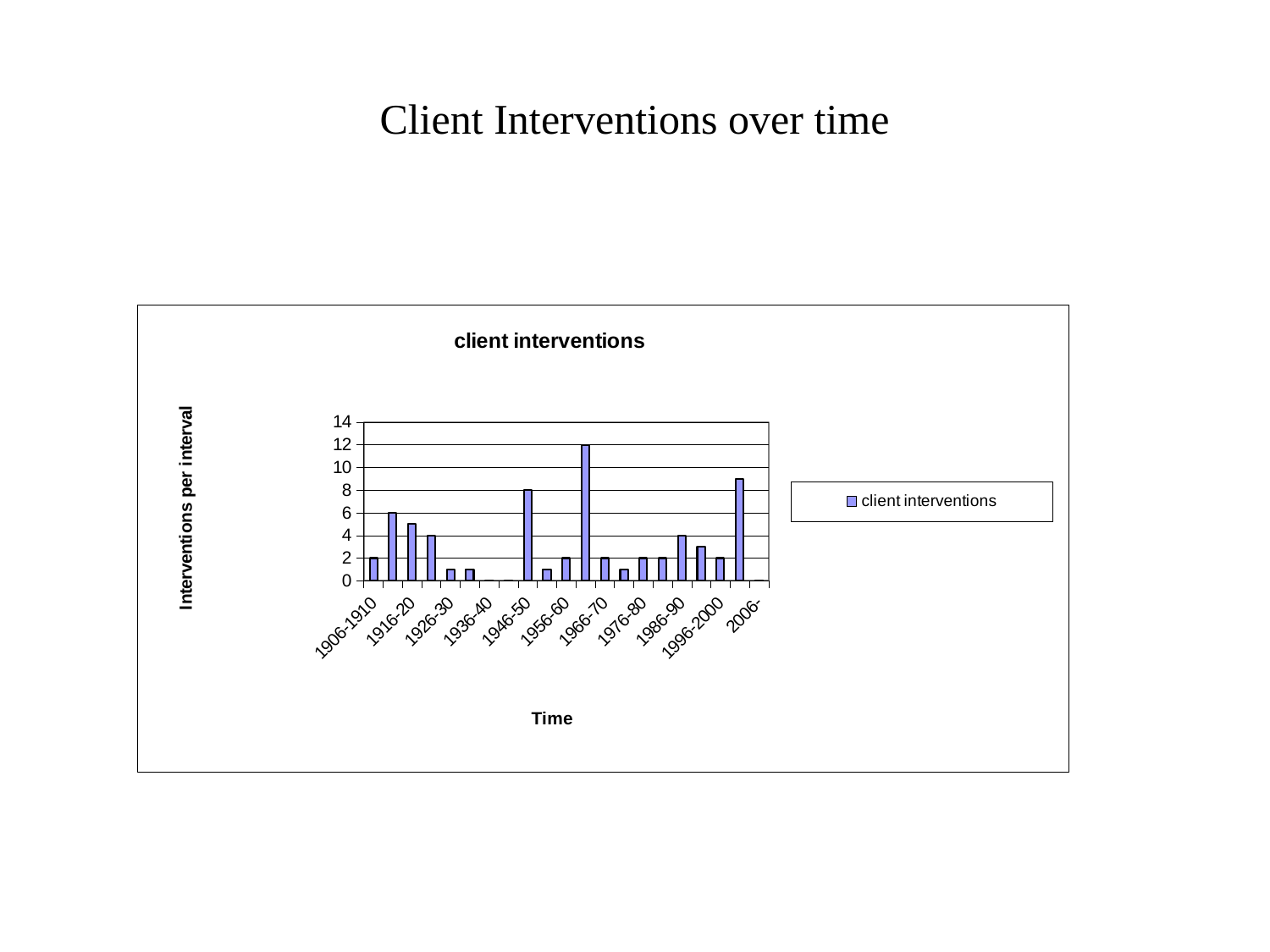
What kind of chart is shown on the slide? bar chart How many series does the legend list? 1 What is the label of the y axis? Interventions per interval What is the value for 2006-? 0 What is the difference between the values for 1946-50 and 1906-1910? 6 What is the value for 1946-50? 8 Is the value for 1926-30 greater or less than 2? less What is the title of the chart? client interventions Is the value for 1916-20 greater or less than 2? greater What is the value for 1986-90? 4 Which is larger, the value for 1946-50 or the value for 1986-90? 1946-50 What is the value for 1906-1910? 2